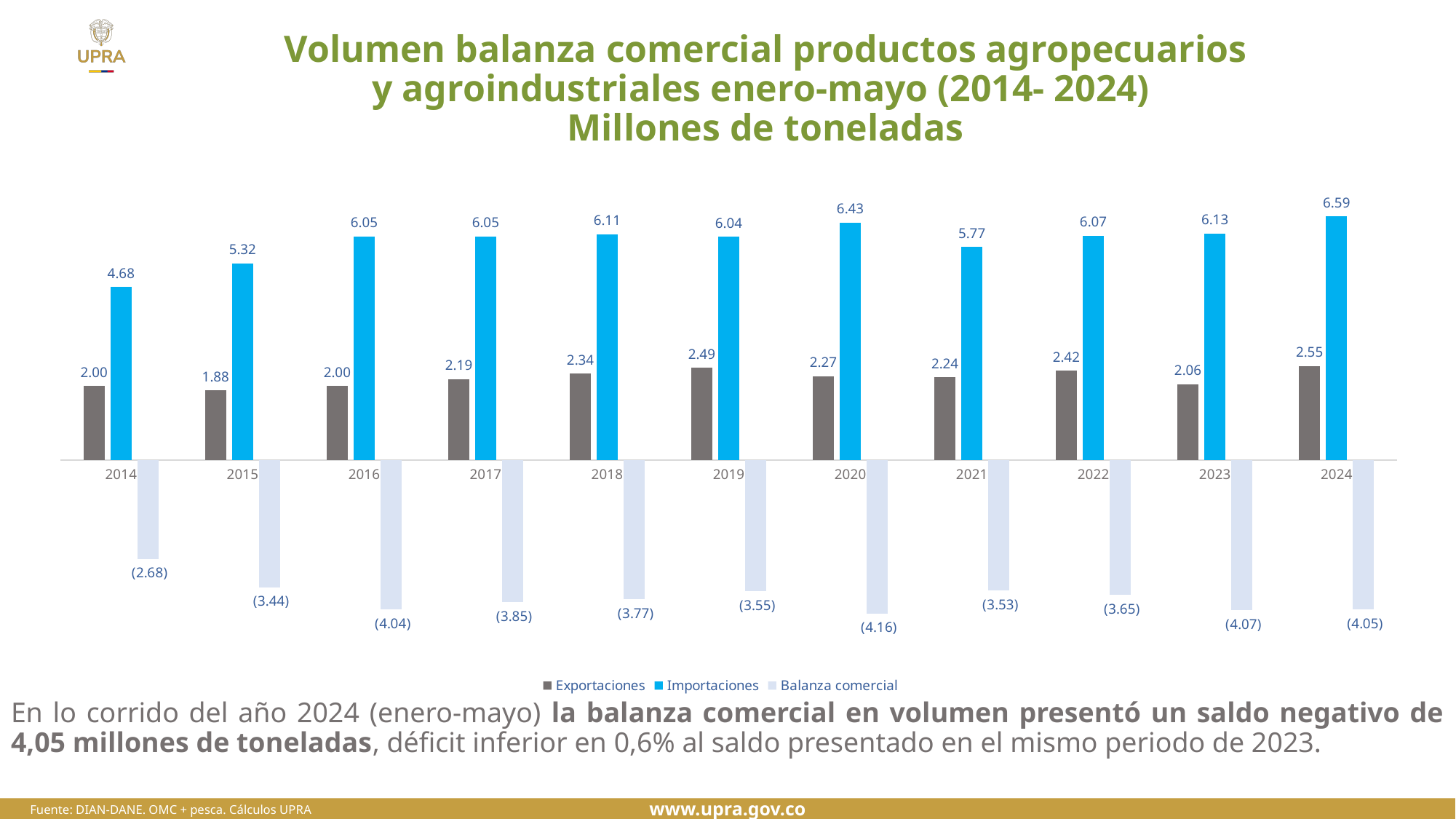
What is the value of Importaciones in 2024? 6.59 Which is larger, Exportaciones in 2022 or Exportaciones in 2023? Exportaciones in 2022 What kind of chart is shown on the slide? Bar chart Which year has the lowest Exportaciones value? 2015 What is the value of Exportaciones in 2019? 2.49 Did Importaciones rise or fall from 2023 to 2024? Rise How many years are shown on the x axis? 11 What is the difference between Importaciones and Exportaciones in 2014? 2.68 What is the value of Balanza comercial in 2020? (4.16) What colour are the Importaciones bars? Blue How many series does the legend list? 3 Which year has the highest Importaciones value? 2024